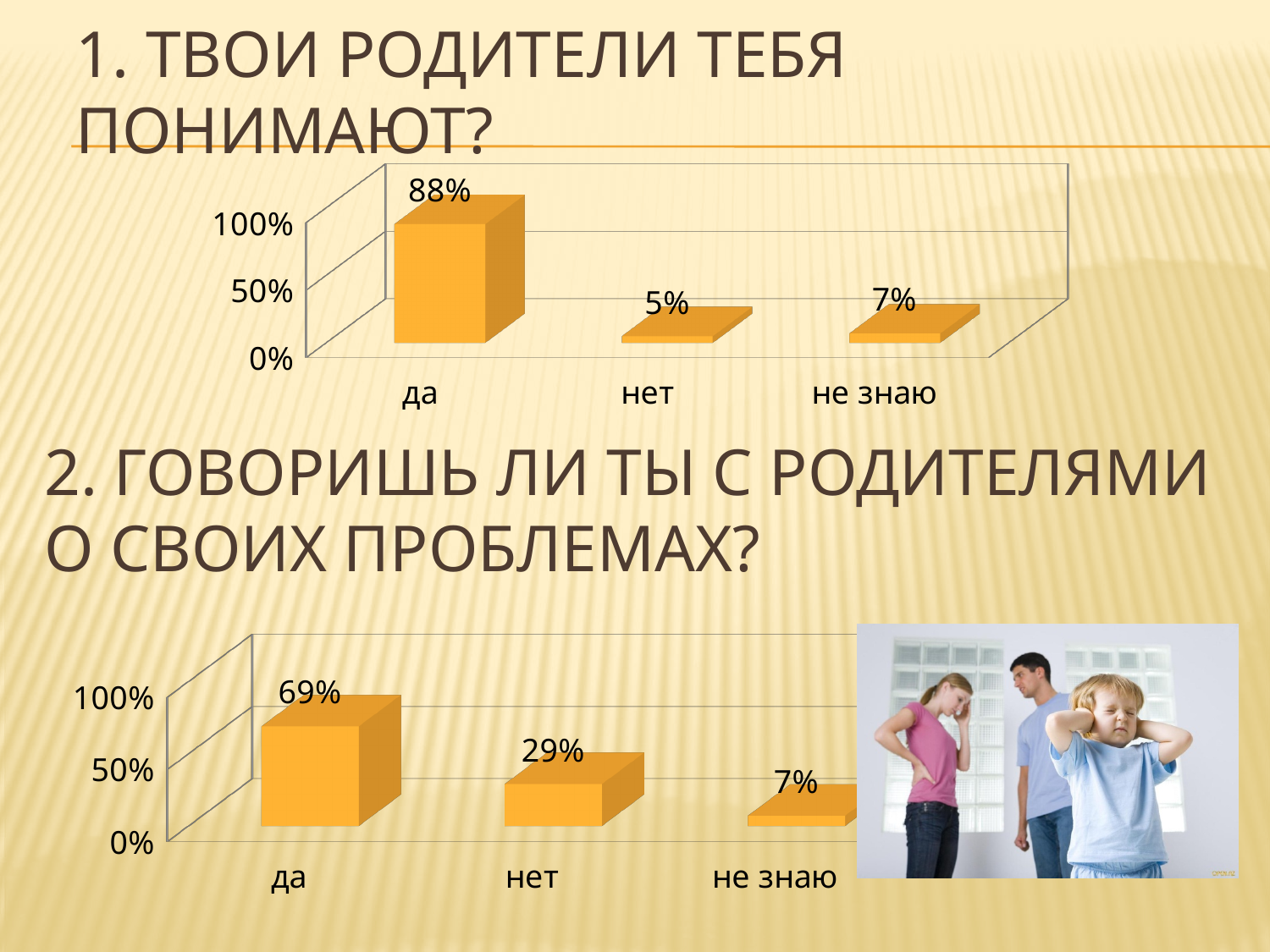
In the top chart (question 1), what is the difference between 'да' and 'не знаю'? 81% In the top chart (question 1, 'Твои родители тебя понимают?'), what is the value for 'да'? 88% In the top chart (question 1), which category has the lowest value? нет In the bottom chart (question 2), what is the difference between 'да' and 'нет'? 40% In the bottom chart (question 2), which category has the highest value? да In the bottom chart (question 2), what is the value for 'нет'? 29% What kind of chart is the bottom chart (question 2)? bar chart How many categories does the top chart (question 1) show? 3 In the bottom chart (question 2, 'Говоришь ли ты с родителями о своих проблемах?'), what is the value for 'да'? 69% In the top chart (question 1), what is the value for 'нет'? 5% In the top chart (question 1), what is the value for 'не знаю'? 7% In the bottom chart (question 2), which is larger: 'нет' or 'не знаю'? нет